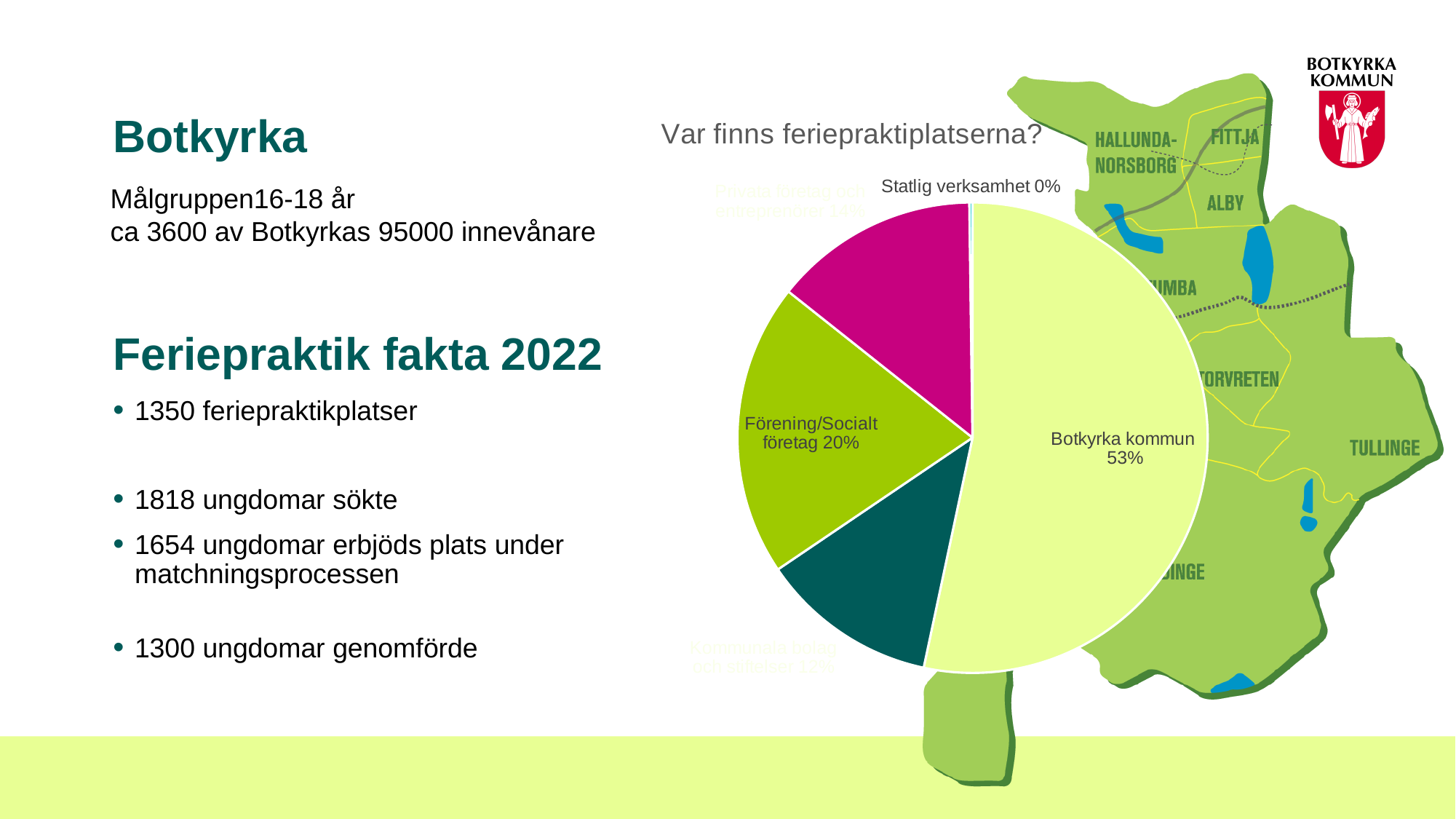
What is the title of the pie chart? Var finns feriepraktiplatserna? What share of the pie does Förening/Socialt företag have? 20% Which is larger, the slice for Botkyrka kommun or the slice for Förening/Socialt företag? Botkyrka kommun Is the share for Botkyrka kommun greater or less than 50%? greater How many slices does the pie chart have? 5 Which category has the smallest slice of the pie? Statlig verksamhet What colour is the Förening/Socialt företag slice? green Which category has the largest slice of the pie? Botkyrka kommun What share of the pie does Botkyrka kommun have? 53% What share of the pie does Statlig verksamhet have? 0% What is the difference in percentage points between the Botkyrka kommun slice and the Förening/Socialt företag slice? 33 What kind of chart is shown on the slide? pie chart